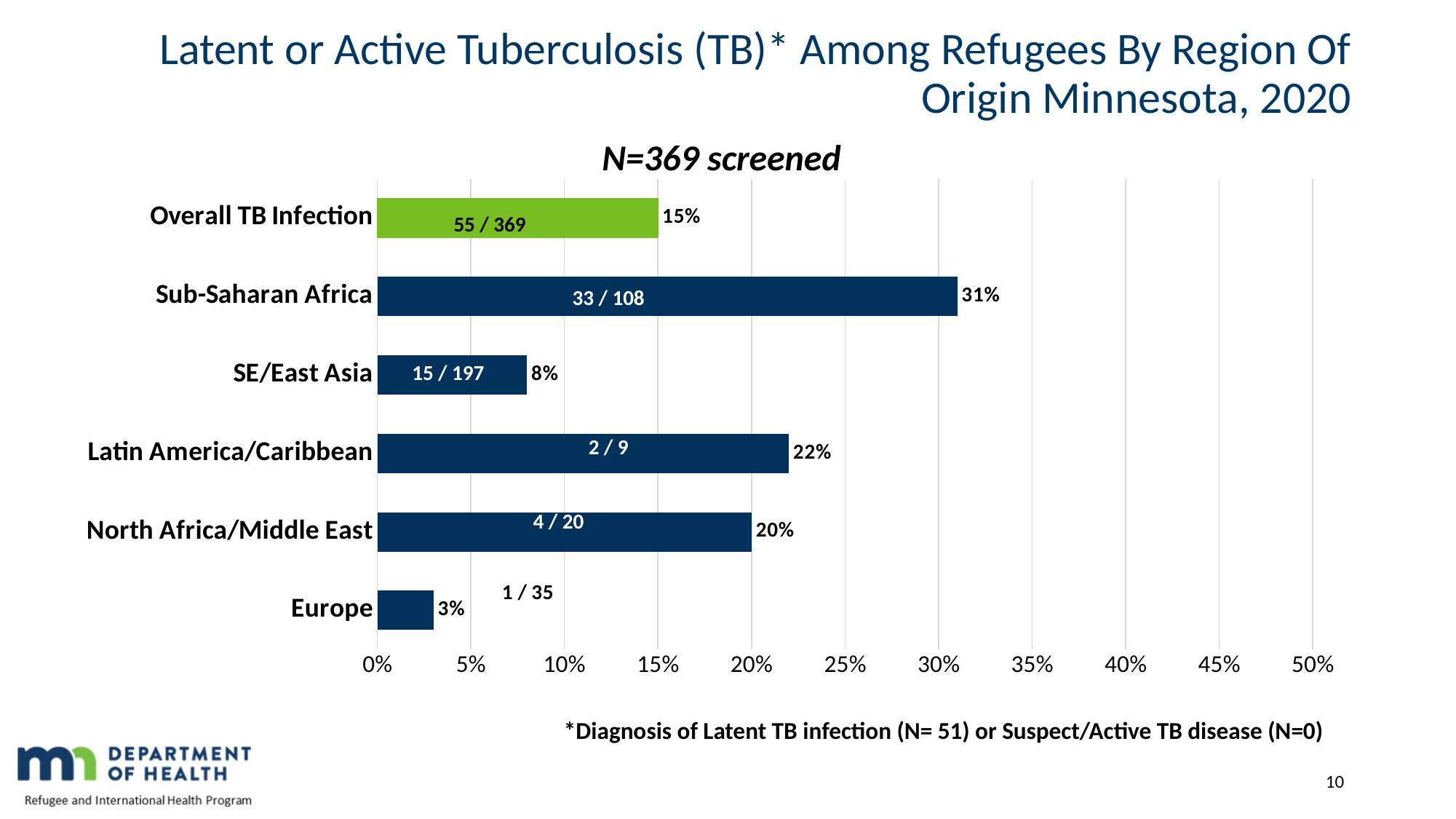
What is the difference in percentage points between Sub-Saharan Africa and SE/East Asia? 23 Is the value for Sub-Saharan Africa greater or less than 30%? greater How many refugees were screened according to the chart subtitle? 369 What kind of chart is shown on the slide? Bar chart Which region has the lowest percentage of TB infection? Europe What percentage is shown for Overall TB Infection? 15% How many bars are shown in the chart? 6 What percentage is shown for Europe? 3% What percentage is shown for Sub-Saharan Africa? 31% Which has a higher percentage, Latin America/Caribbean or North Africa/Middle East? Latin America/Caribbean Which region has the highest percentage of TB infection? Sub-Saharan Africa What fraction label is shown on the SE/East Asia bar? 15 / 197